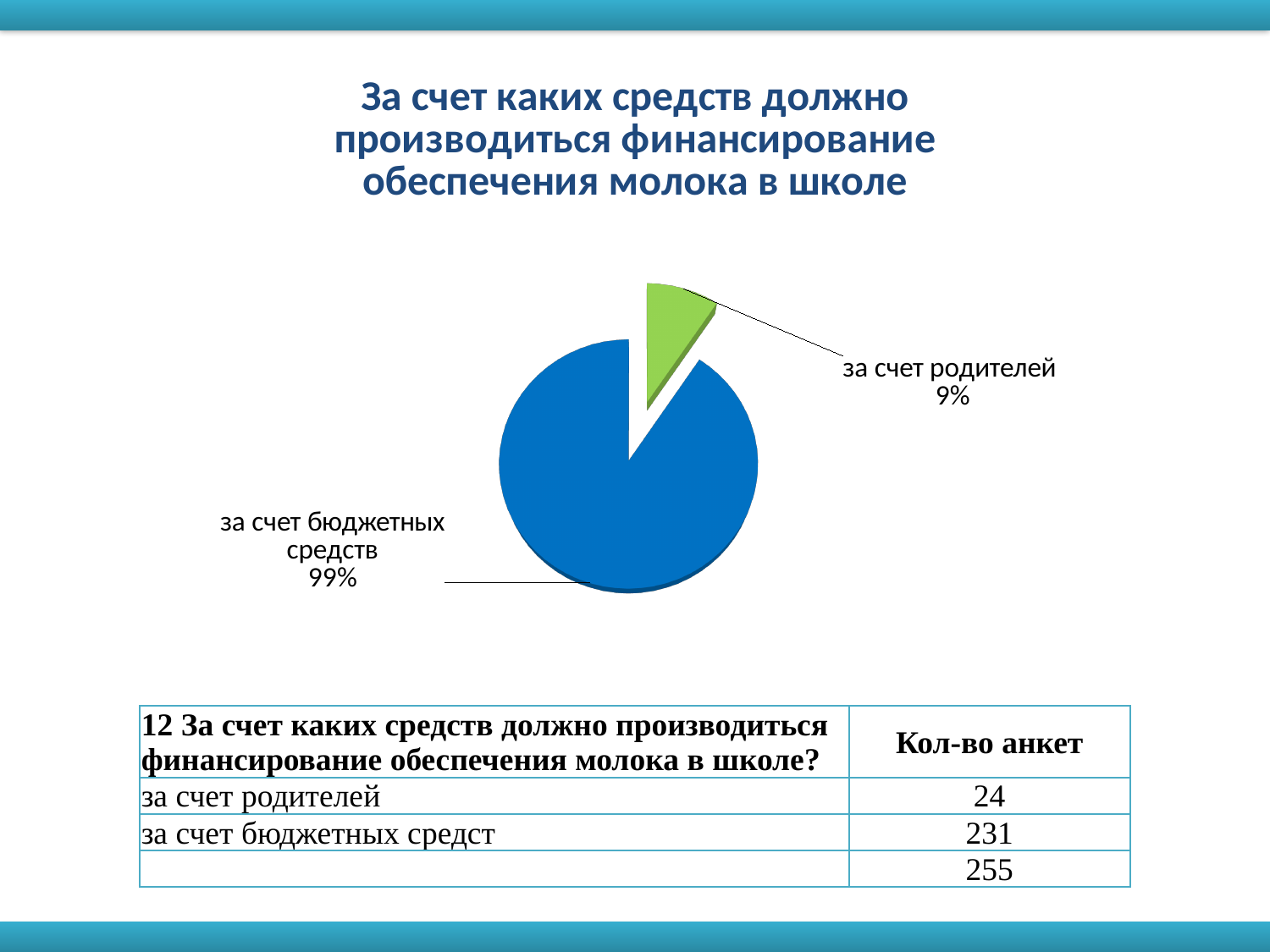
How many slices does the pie chart have? 2 Which is larger: the slice for "за счет родителей" or the slice for "за счет бюджетных средств"? за счет бюджетных средств What is the title of the chart? За счет каких средств должно производиться финансирование обеспечения молока в школе What colour is the slice for "за счет родителей"? green Which slice of the pie chart is the largest? за счет бюджетных средств What share of the pie is labelled for "за счет родителей"? 9% What kind of chart is shown on the slide? pie chart What percentage is shown for the slice "за счет родителей"? 9% Which slice of the pie chart is the smallest? за счет родителей What percentage is shown for the slice "за счет бюджетных средств"? 99%